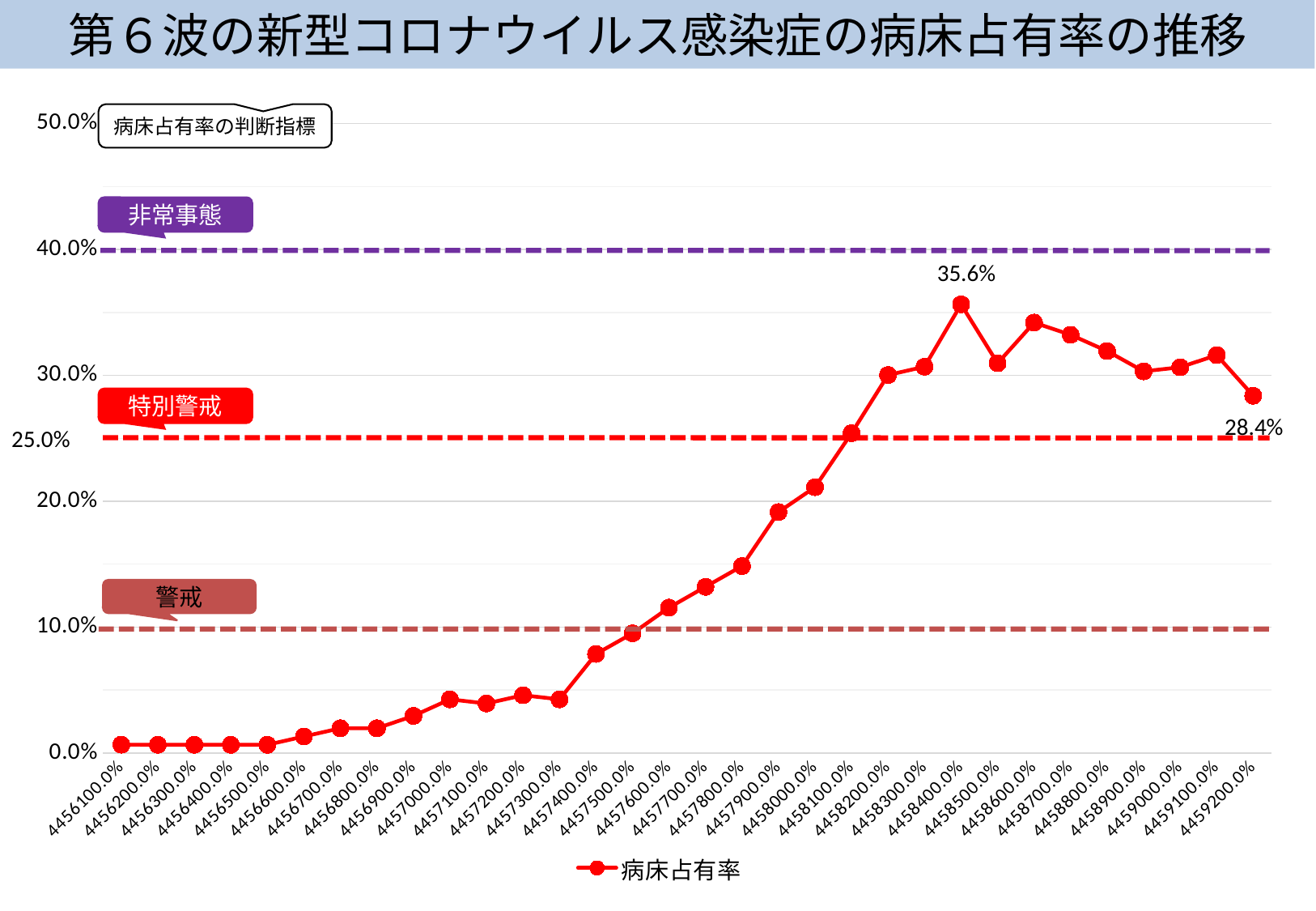
What is the title of the chart? 第６波の新型コロナウイルス感染症の病床占有率の推移 Overall, does the 病床占有率 line rise or fall from the first point to the last point along the x axis? rise Is the value for 4456100.0% greater or less than 10.0%? less Which is larger, the value at 4458400.0% or the value at 4459200.0%? 4458400.0% What is the difference between the peak value (35.6%) and the final value (28.4%) of 病床占有率? 7.2 percentage points What is the value of 病床占有率 at the last point on the chart (4459200.0%)? 28.4% How many series does the legend list? 1 What kind of chart is shown on the slide? line chart Is the value for 4458400.0% greater or less than 30.0%? greater What label is attached to the purple dashed line at 40.0%? 非常事態 How many data points are plotted on the 病床占有率 line? 32 What is the highest value of 病床占有率 shown on the chart? 35.6%